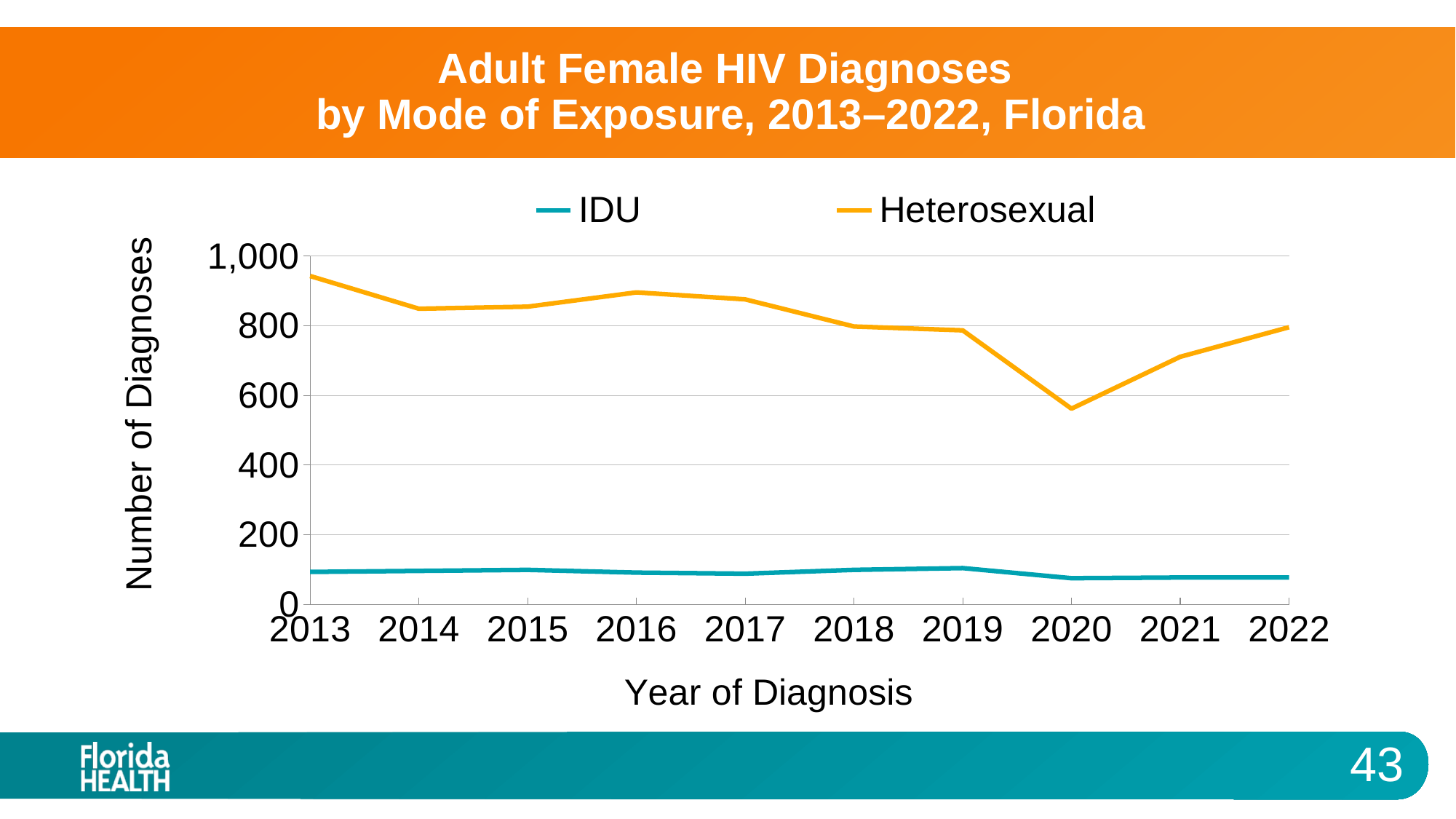
Is the IDU value for 2019 greater or less than 200? less What kind of chart is shown on the slide? line chart In which year is the Heterosexual series at its lowest? 2020 What is the label of the y axis? Number of Diagnoses Is the Heterosexual value for 2020 greater or less than 600? less How many years are plotted along the x axis? 10 How many series does the legend list? 2 In which year is the Heterosexual series at its highest? 2013 What is the title of the chart? Adult Female HIV Diagnoses by Mode of Exposure, 2013–2022, Florida Is the Heterosexual value for 2013 greater or less than 800? greater Does the Heterosexual series rise or fall from 2020 to 2022? rise Which series has the higher value in 2013, IDU or Heterosexual? Heterosexual